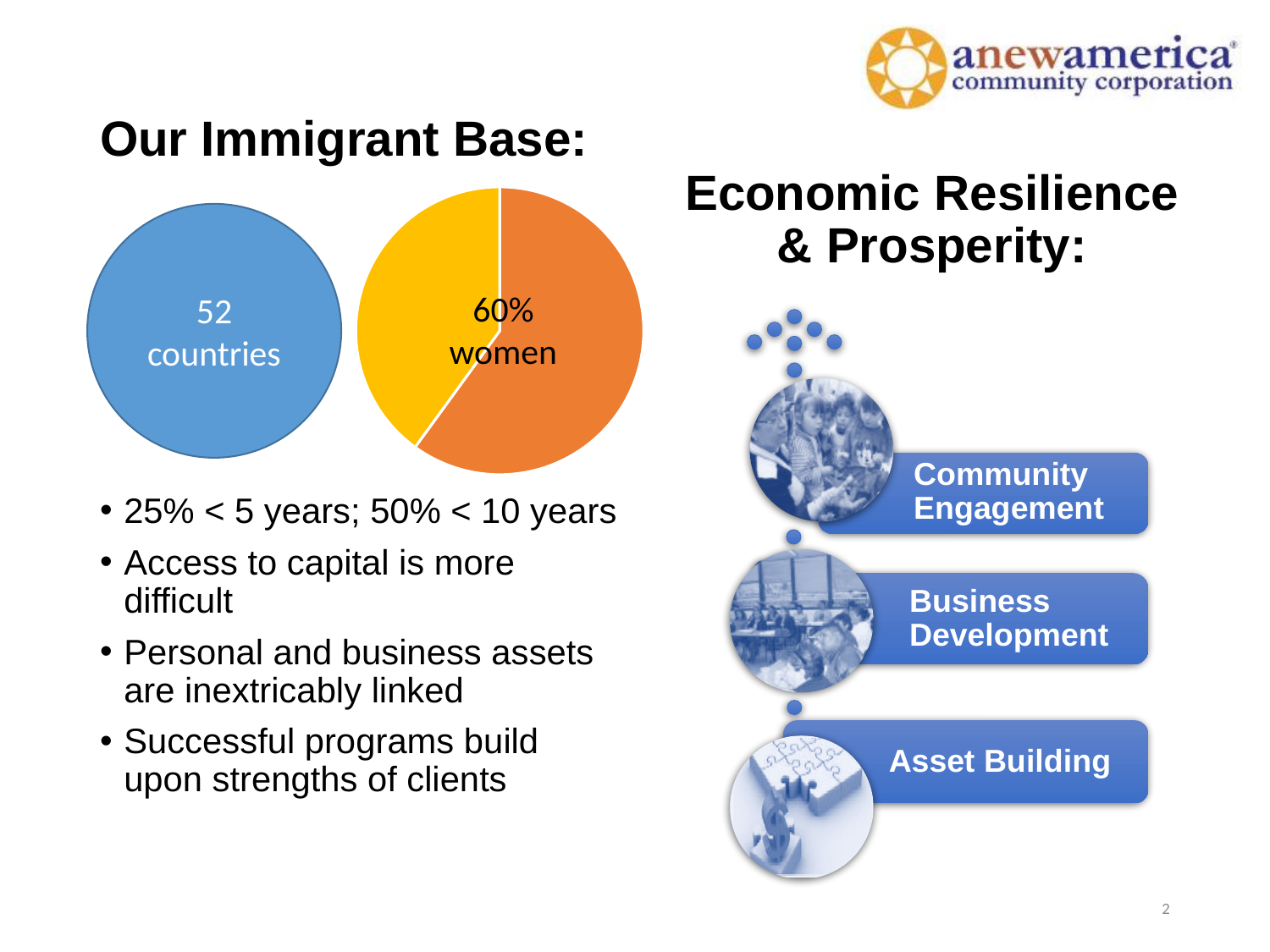
In the pie chart, what share of the immigrant base is women? 60% Which colour in the pie chart represents the 60% women slice? orange In the pie chart, which slice is larger, the orange slice or the yellow slice? orange How many slices does the pie chart have? 2 In the pie chart, what share of the pie is not women? 40% In the pie chart, is the share for women greater or less than 50%? greater What is the heading above the pie chart? Our Immigrant Base: What kind of chart is shown under the heading "Our Immigrant Base:"? pie chart